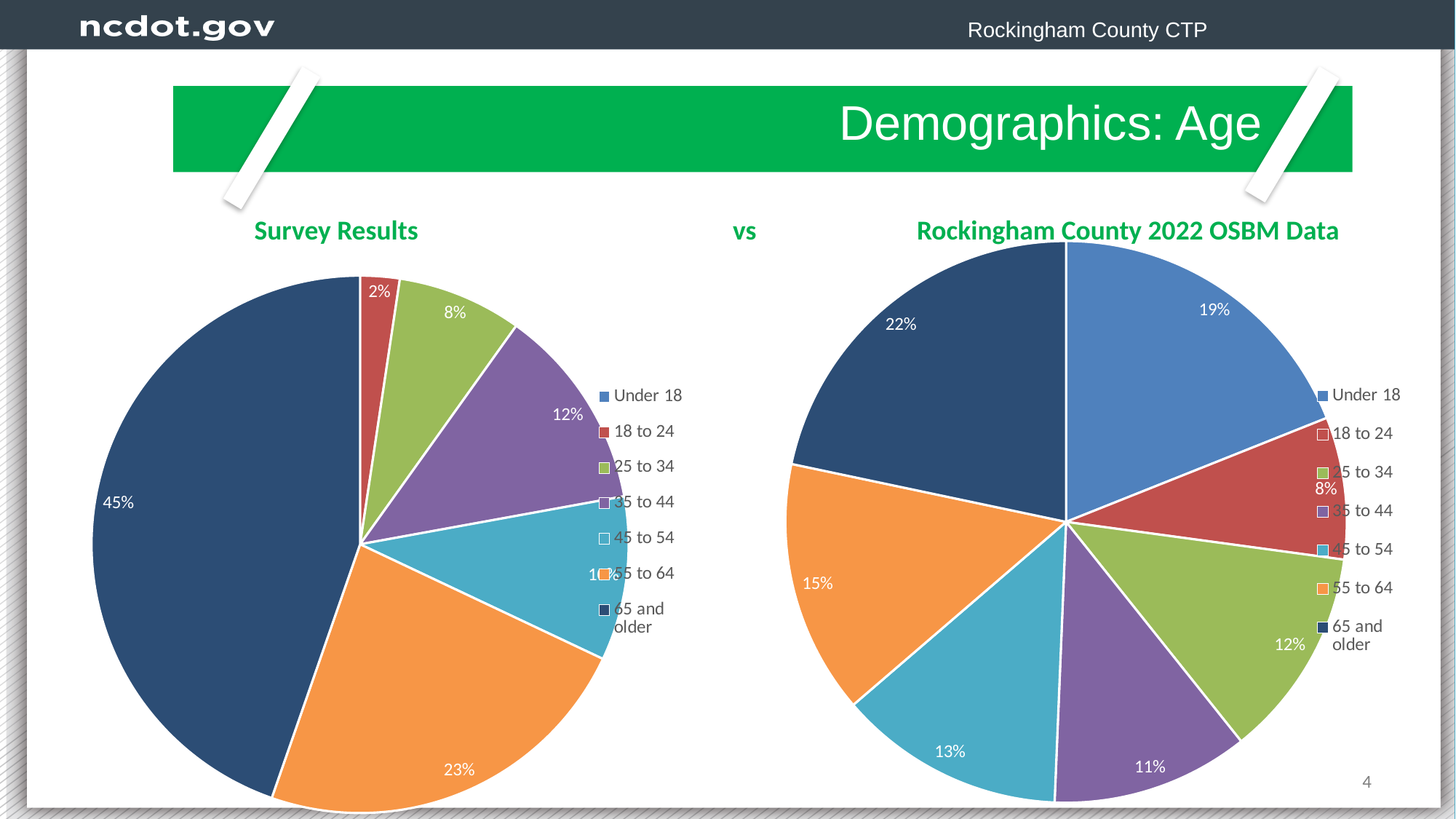
In the Rockingham County 2022 OSBM Data pie chart, which age group has the smallest slice? 18 to 24 In the Survey Results pie chart, what share is shown for the 18 to 24 group? 2% In the Survey Results pie chart, what share is shown for the 55 to 64 group? 23% In the Rockingham County 2022 OSBM Data pie chart, what share is shown for the Under 18 group? 19% In the Survey Results pie chart, which age group has the largest slice? 65 and older In the Survey Results pie chart, what is the difference between the 35 to 44 share and the 25 to 34 share? 4% In the Rockingham County 2022 OSBM Data pie chart, what share is shown for the 45 to 54 group? 13% In the Rockingham County 2022 OSBM Data pie chart, which age group has the largest slice? 65 and older What type of chart is used for the Survey Results? Pie chart In the Rockingham County 2022 OSBM Data pie chart, which is larger: the 55 to 64 share or the 35 to 44 share? 55 to 64 How many age groups does the legend of the Rockingham County 2022 OSBM Data chart list? 7 In the Survey Results pie chart, what share is shown for the 65 and older group? 45%